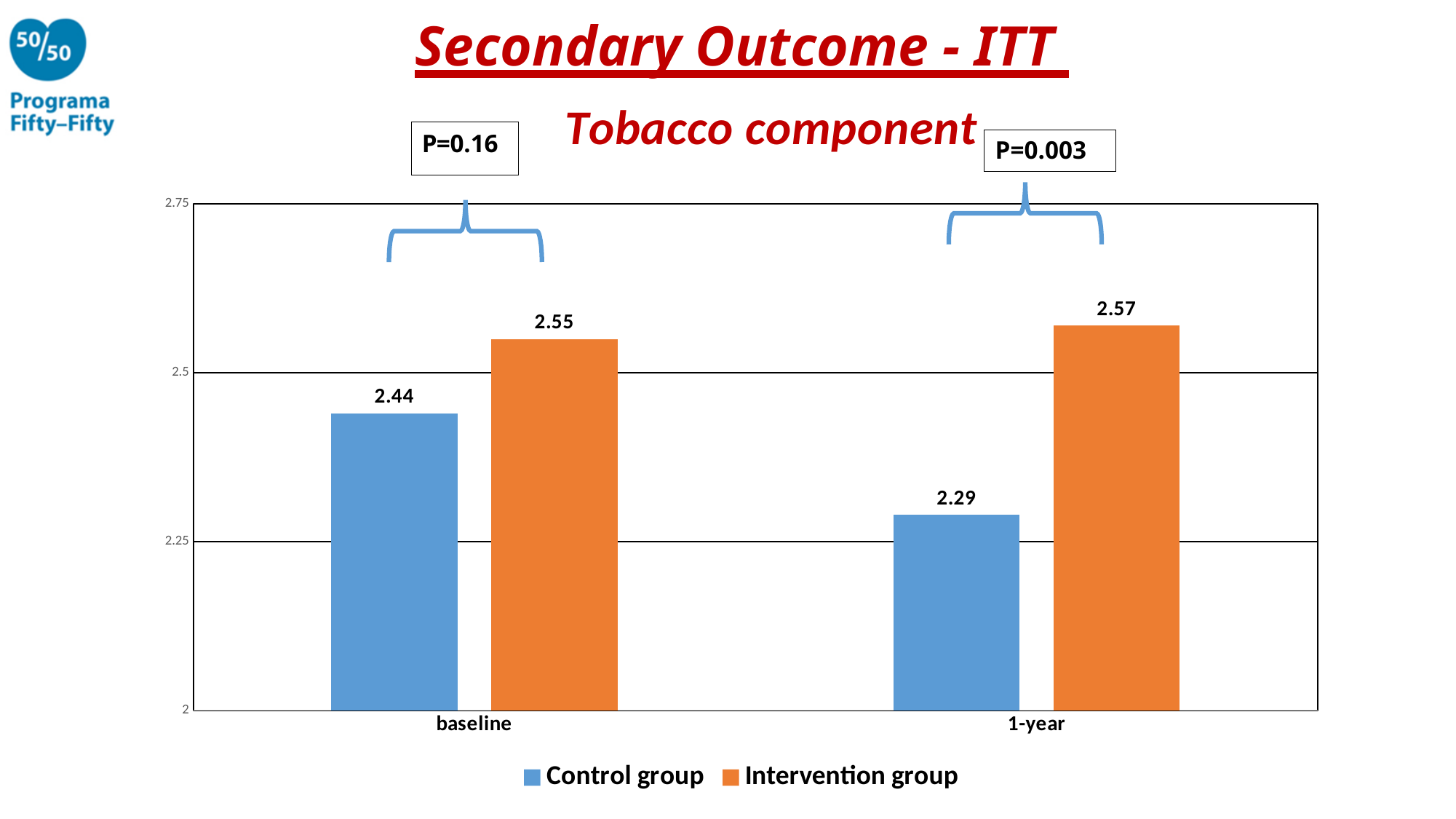
What is the value for the Control group at 1-year? 2.29 What is the value for the Control group at baseline? 2.44 Is the value for the Control group at 1-year greater or less than 2.5? less Which is larger at baseline, the Control group or the Intervention group? Intervention group What is the difference between the Intervention group and the Control group at baseline? 0.11 How many series does the legend list? 2 Which bar has the lowest value on the chart? Control group at 1-year What is the value for the Intervention group at baseline? 2.55 What is the value for the Intervention group at 1-year? 2.57 What kind of chart is shown on the slide? bar chart Does the Control group value rise or fall from baseline to 1-year? fall What is the difference between the Intervention group and the Control group at 1-year? 0.28